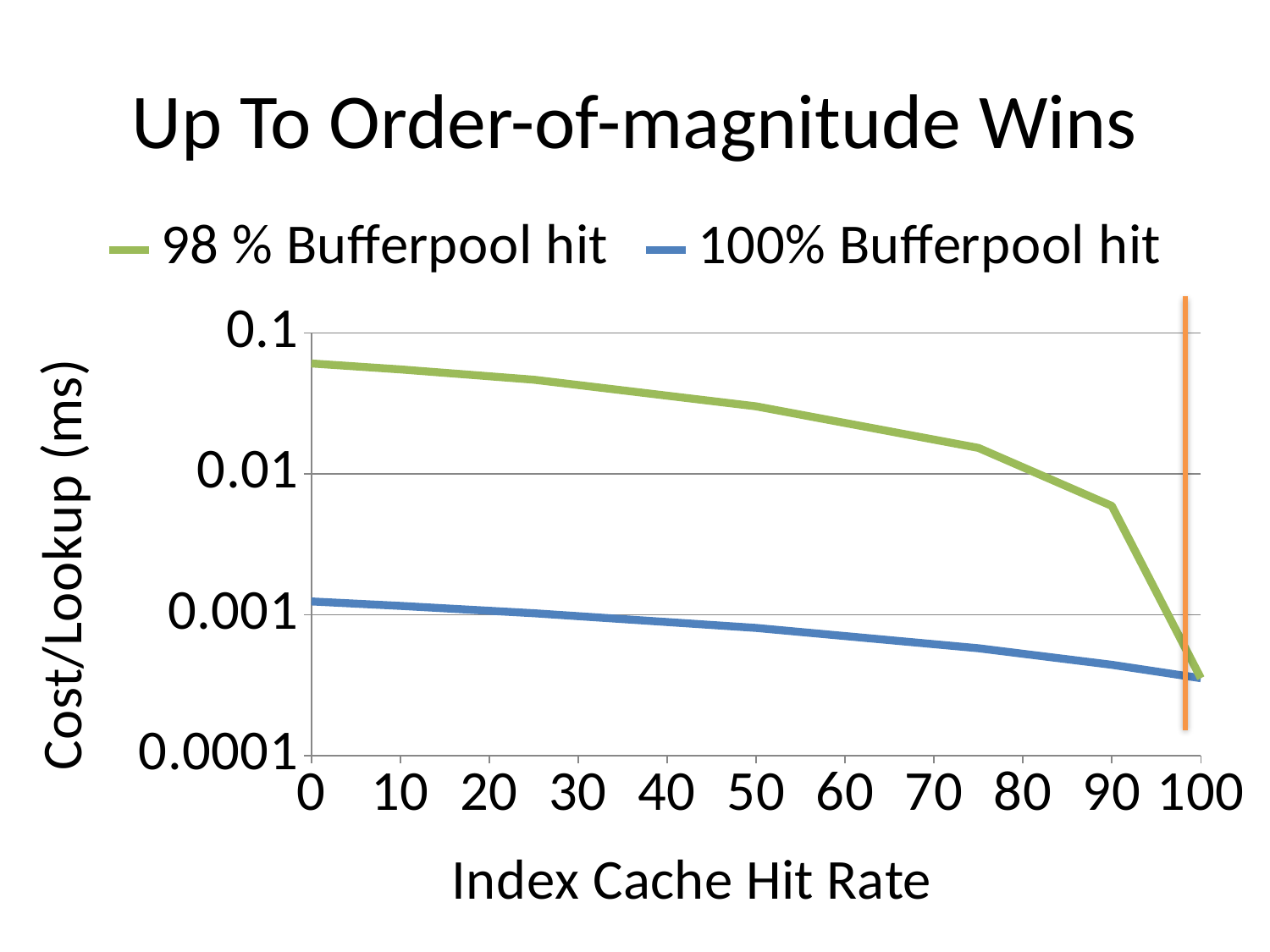
Does the 100% Bufferpool hit series rise or fall as Index Cache Hit Rate increases? fall At an Index Cache Hit Rate of 0, which series has the lower Cost/Lookup: 98 % Bufferpool hit or 100% Bufferpool hit? 100% Bufferpool hit Is the value for 100% Bufferpool hit at an Index Cache Hit Rate of 0 greater or less than 0.01? less Is the value for 98 % Bufferpool hit at an Index Cache Hit Rate of 90 greater or less than 0.01? less What is the label of the y axis? Cost/Lookup (ms) How many series does the legend list? 2 Is the value for 98 % Bufferpool hit at an Index Cache Hit Rate of 0 greater or less than 0.01? greater At an Index Cache Hit Rate of 50, which series has the higher Cost/Lookup: 98 % Bufferpool hit or 100% Bufferpool hit? 98 % Bufferpool hit What kind of chart is shown on the slide? line chart Does the 98 % Bufferpool hit series rise or fall as Index Cache Hit Rate increases? fall What is the title of the chart? Up To Order-of-magnitude Wins